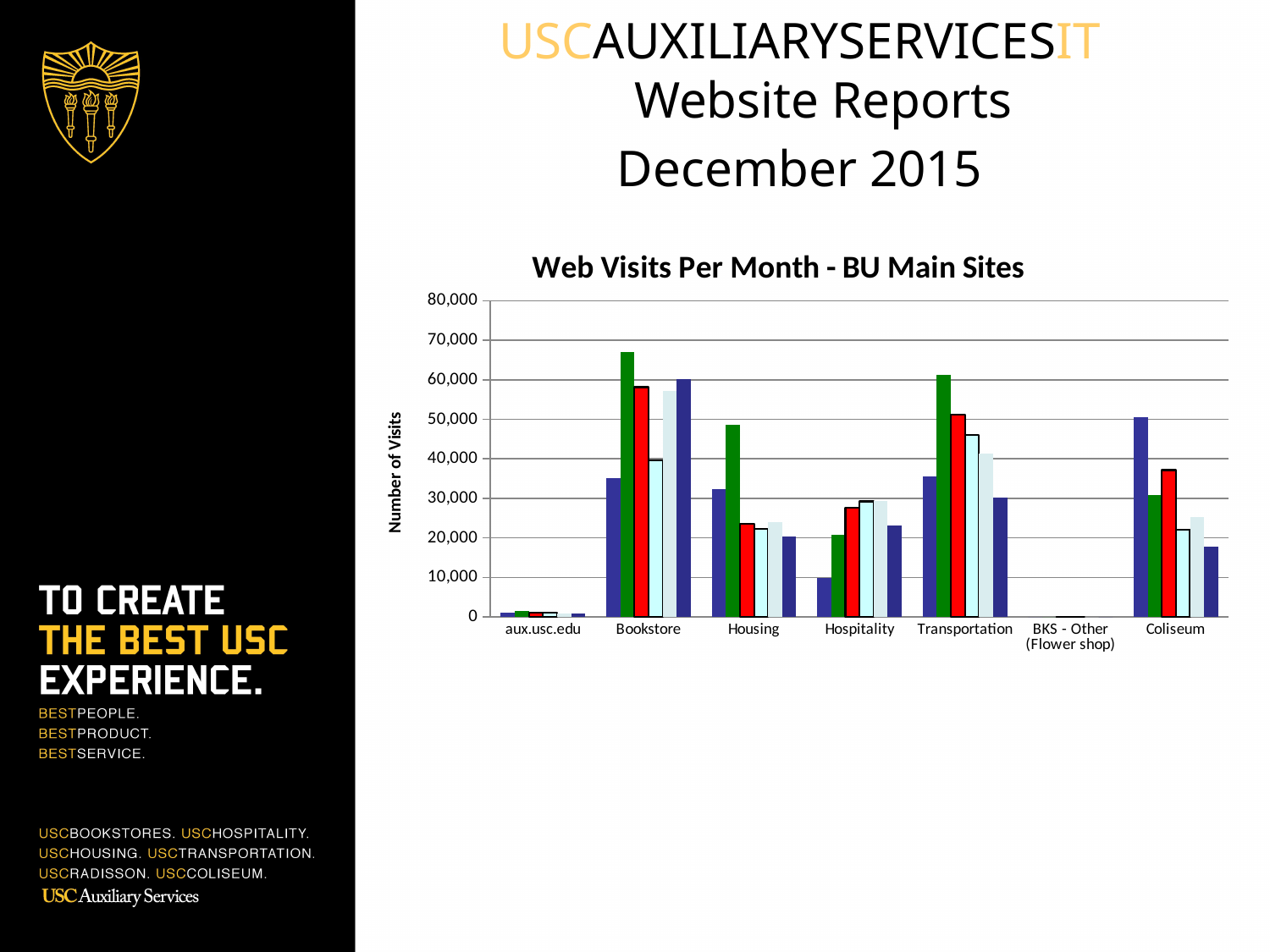
Are the bars for aux.usc.edu greater or less than 10,000? less Is the green bar for Bookstore greater or less than 60,000? greater What is the label on the vertical axis of the chart? Number of Visits Is the green bar for Housing greater or less than 50,000? less For Coliseum, which is larger: the red bar or the green bar? the red bar What is the title of the chart? Web Visits Per Month - BU Main Sites Which is larger: the green bar for Bookstore or the green bar for Housing? Bookstore Which category has the lowest bars overall in the chart? BKS - Other (Flower shop) How many categories are shown along the x axis of the chart? 7 What kind of chart is shown on the slide? bar chart Which category contains the tallest bar in the chart? Bookstore